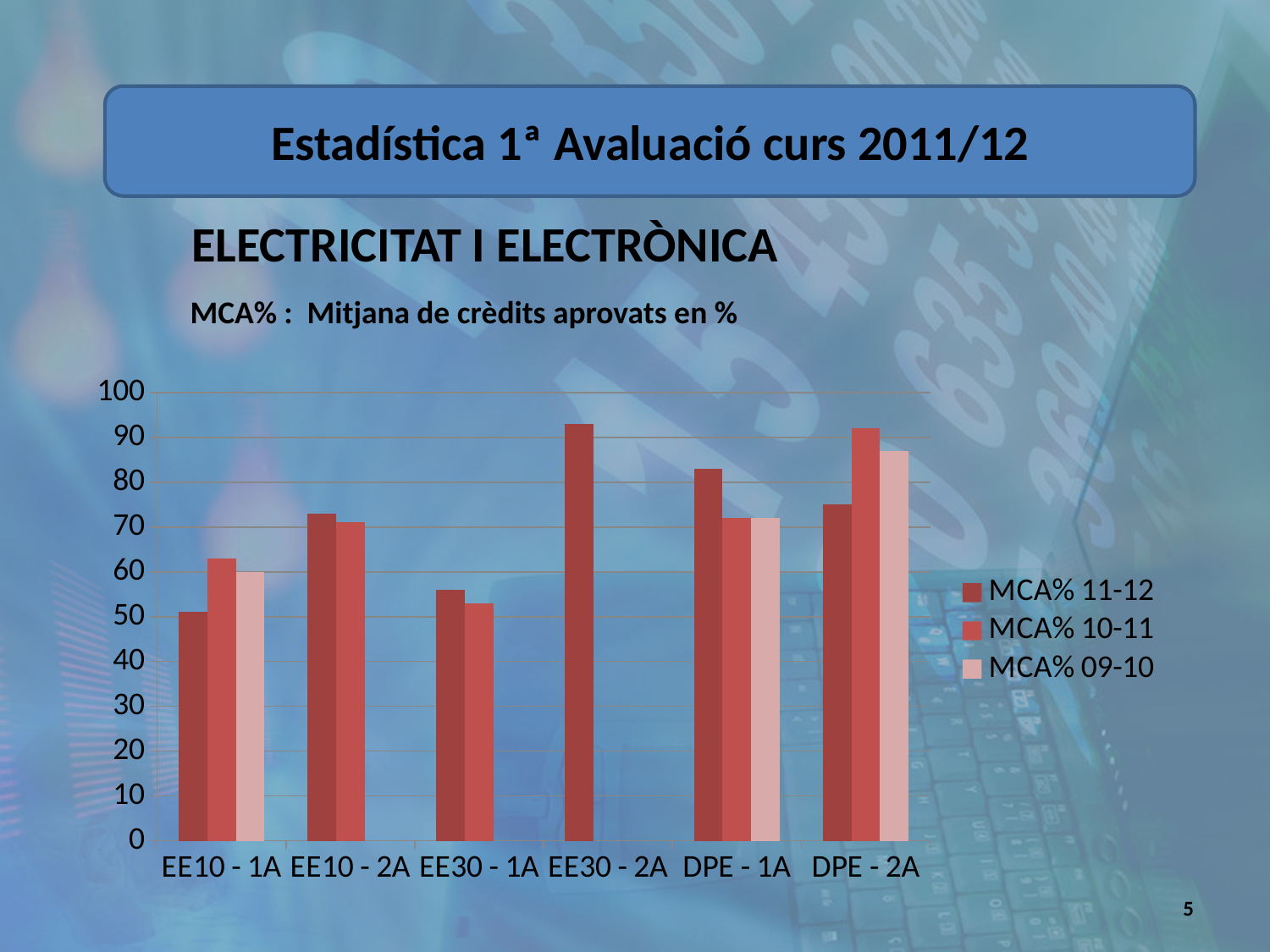
How many series does the legend list? 3 Is the MCA% 11-12 value for EE10 - 1A greater or less than 60? less What kind of chart is shown on the slide? bar chart Is the MCA% 11-12 value for EE30 - 2A greater or less than 90? greater Is the MCA% 11-12 value for DPE - 1A greater or less than 80? greater Which category has the highest MCA% 11-12 value? EE30 - 2A What is the name of the third series in the legend? MCA% 09-10 For DPE - 2A, which is larger: MCA% 11-12 or MCA% 10-11? MCA% 10-11 Which category has the highest MCA% 10-11 value? DPE - 2A Which category has the lowest MCA% 10-11 value? EE30 - 1A For DPE - 1A, which is larger: MCA% 11-12 or MCA% 10-11? MCA% 11-12 How many categories are shown on the x axis? 6